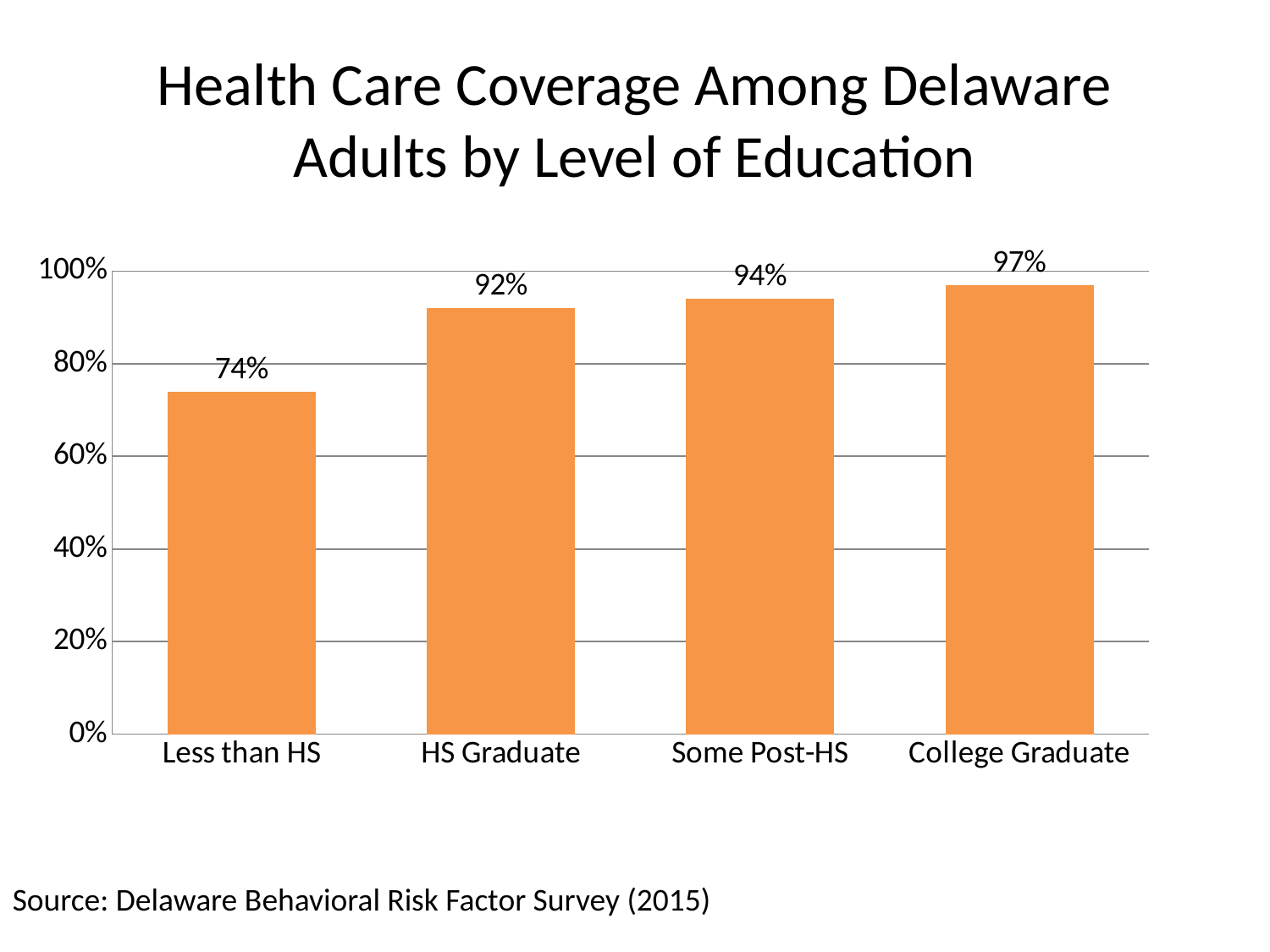
What is the health care coverage rate for adults with less than a high school education? 74% Which has a higher coverage rate, HS Graduate or Some Post-HS? Some Post-HS What is the difference in coverage between HS Graduate and Less than HS? 18 percentage points What type of chart is shown on the slide? Bar chart What is the difference in coverage between College Graduate and Less than HS? 23 percentage points What is the health care coverage rate for College Graduate? 97% Which education level has the highest health care coverage rate? College Graduate How many education levels are shown in the chart? 4 Which education level has the lowest health care coverage rate? Less than HS What is the health care coverage rate for HS Graduate? 92% What is the health care coverage rate for Some Post-HS? 94% Do the coverage rates rise or fall as education level increases from left to right? Rise